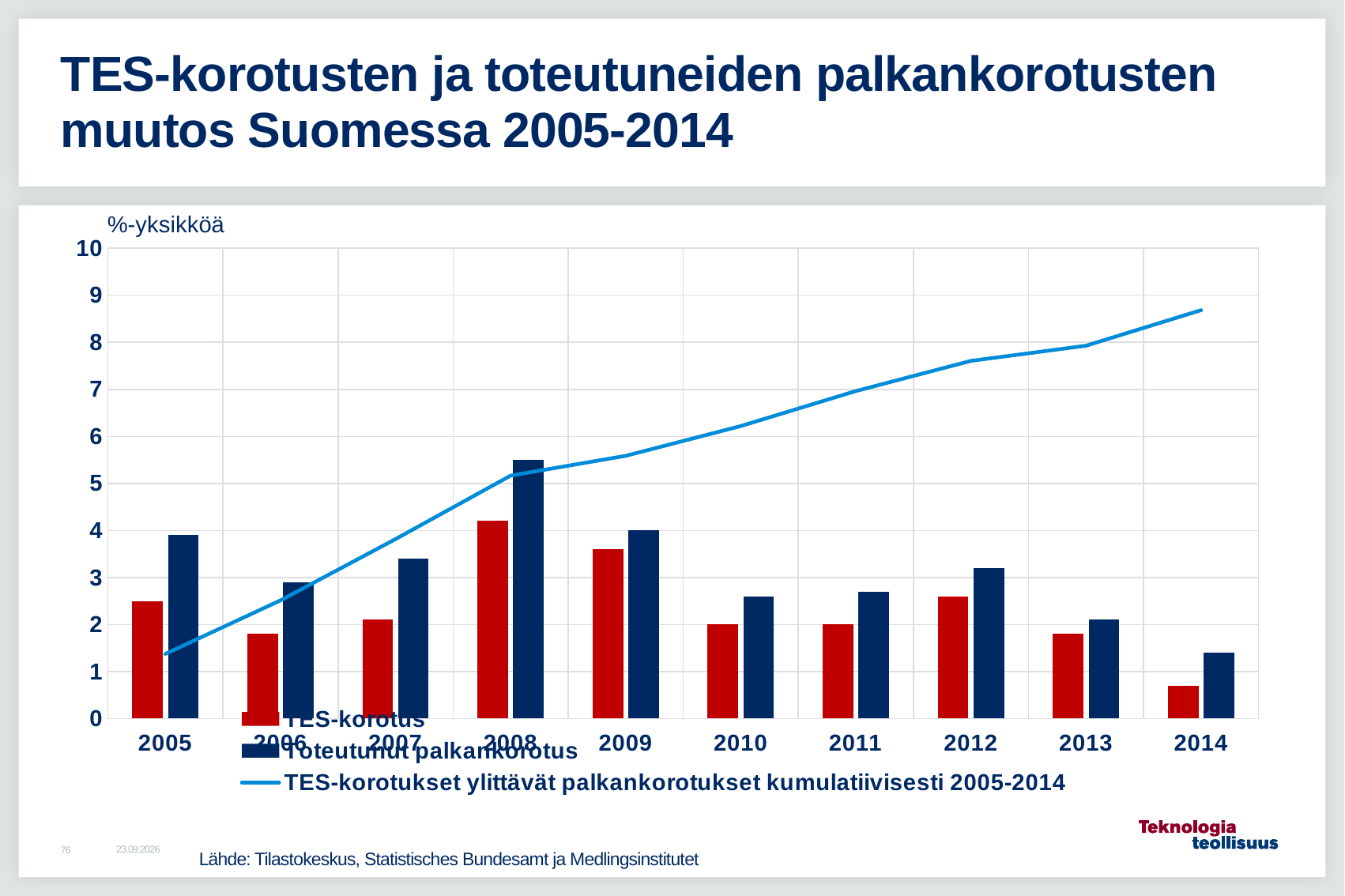
Is the Toteutunut palkankorotus value for 2010 greater or less than 3? less Which year has the lowest Toteutunut palkankorotus bar? 2014 Is the TES-korotus value for 2014 greater or less than 1? less What unit is shown on the y axis label? %-yksikköä Is the value of the cumulative line (TES-korotukset ylittävät palkankorotukset kumulatiivisesti) in 2014 greater or less than 8? greater Which is larger, the Toteutunut palkankorotus bar for 2005 or for 2006? 2005 Does the cumulative line (TES-korotukset ylittävät palkankorotukset kumulatiivisesti 2005-2014) rise or fall from 2005 to 2014? rise Which is larger, the TES-korotus bar for 2009 or for 2012? 2009 How many years are shown on the x axis? 10 How many series does the legend list? 3 Which year has the highest TES-korotus bar? 2008